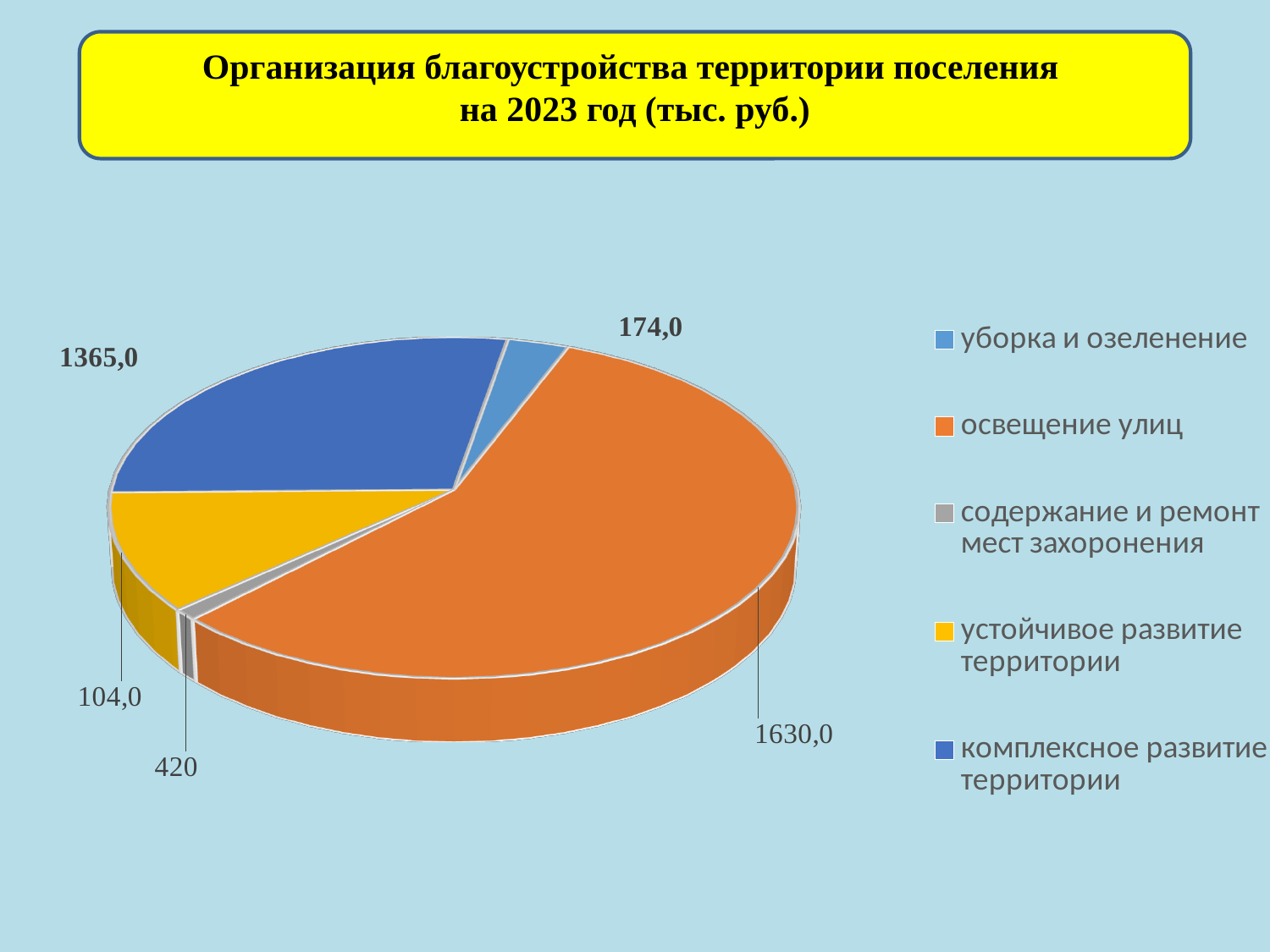
What is the title of the chart? Организация благоустройства территории поселения на 2023 год (тыс. руб.) What is the value for освещение улиц? 1630,0 What colour is the slice for освещение улиц? Orange What type of chart is shown on the slide? Pie chart What is the value for комплексное развитие территории? 1365,0 What is the value for уборка и озеленение? 174,0 What is the smallest value labelled on the pie chart? 104,0 Which category has the largest slice of the pie? освещение улиц What is the difference between the values for освещение улиц and уборка и озеленение? 1456,0 What is the difference between the values for освещение улиц and комплексное развитие территории? 265,0 How many categories does the pie chart show? 5 Which is larger: освещение улиц or комплексное развитие территории? освещение улиц